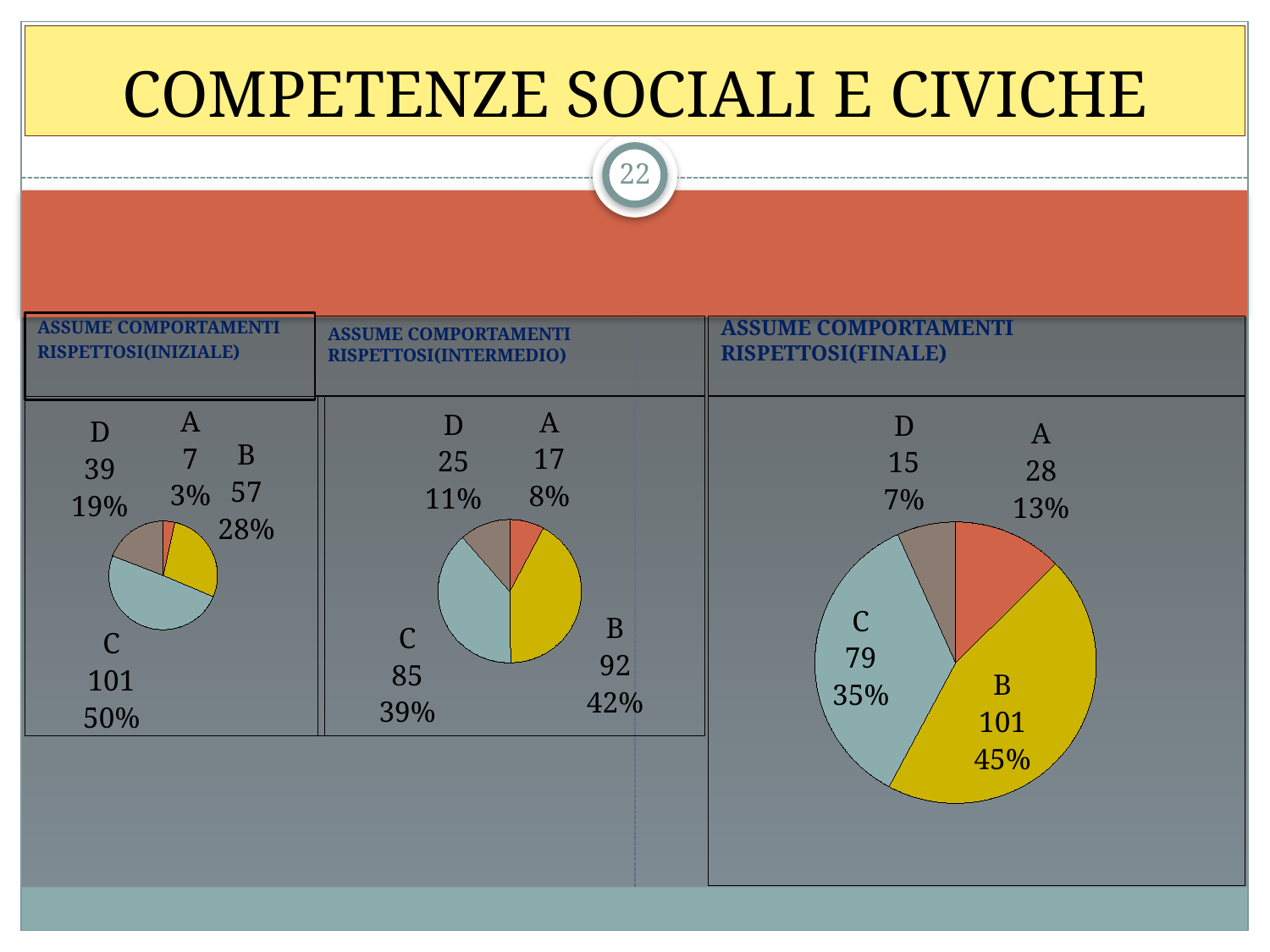
In the chart titled 'ASSUME COMPORTAMENTI RISPETTOSI(FINALE)', what is the difference between the values for B and C? 22 What kind of chart is the chart titled 'ASSUME COMPORTAMENTI RISPETTOSI(FINALE)'? Pie chart In the chart titled 'ASSUME COMPORTAMENTI RISPETTOSI(INTERMEDIO)', what is the value for category B? 92 In the chart titled 'ASSUME COMPORTAMENTI RISPETTOSI(INTERMEDIO)', what is the difference between the values for C and D? 60 In the chart titled 'ASSUME COMPORTAMENTI RISPETTOSI(INTERMEDIO)', which category has the lowest value? A How many categories does the chart titled 'ASSUME COMPORTAMENTI RISPETTOSI(INTERMEDIO)' show? 4 In the chart titled 'ASSUME COMPORTAMENTI RISPETTOSI(INIZIALE)', what percentage share does category A have? 3% How many pie charts are shown on the slide? 3 In the chart titled 'ASSUME COMPORTAMENTI RISPETTOSI(INIZIALE)', which is larger, the value for D or the value for B? B In the chart titled 'ASSUME COMPORTAMENTI RISPETTOSI(INIZIALE)', what is the value for category C? 101 In the chart titled 'ASSUME COMPORTAMENTI RISPETTOSI(FINALE)', what percentage share does category C have? 35% In the chart titled 'ASSUME COMPORTAMENTI RISPETTOSI(FINALE)', which category has the highest value? B